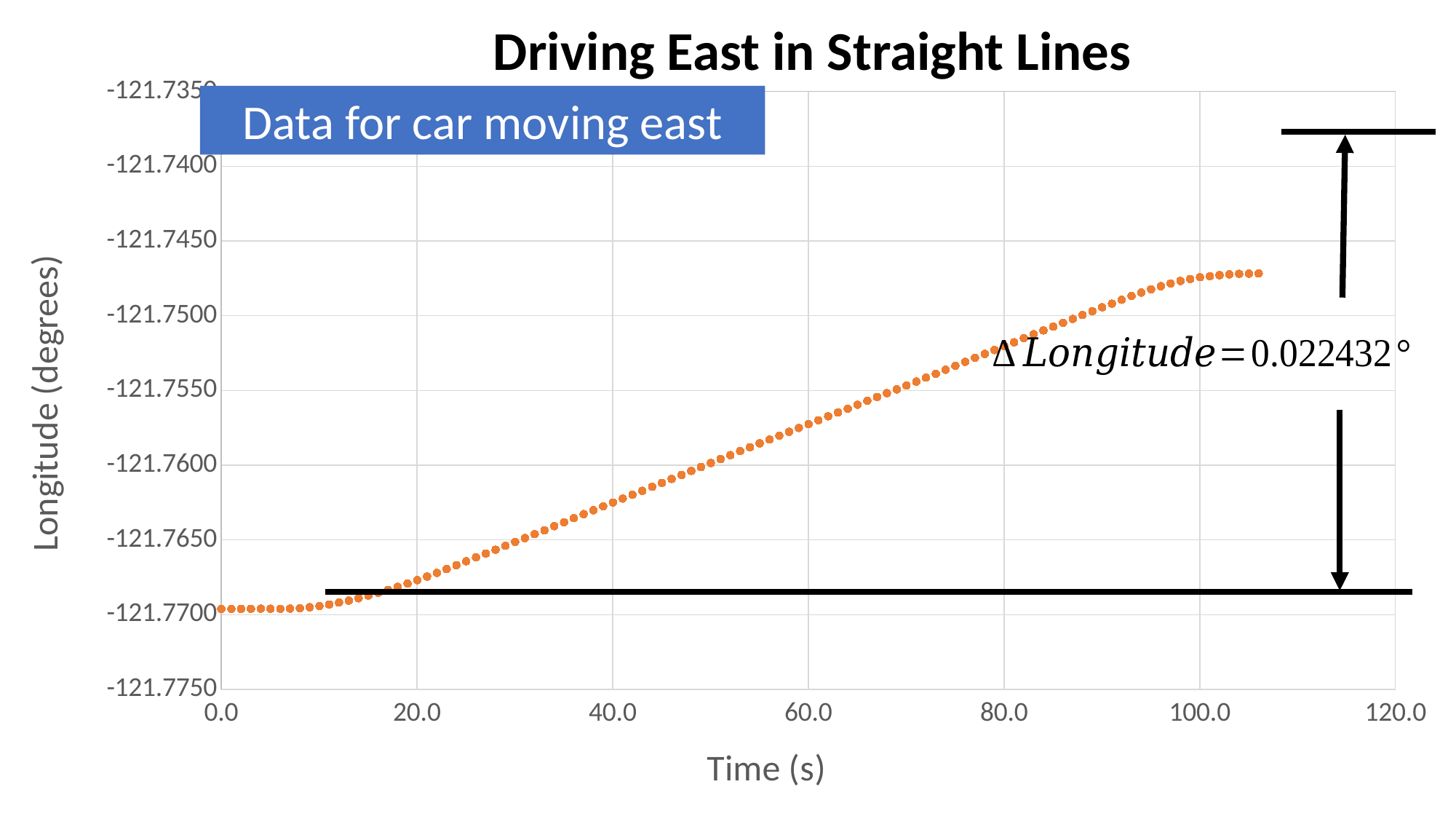
Is the longitude at time 40.0 s greater or less than -121.7650? greater What value of ΔLongitude is annotated on the chart? 0.022432° Is the longitude at time 0.0 s greater or less than -121.7650? less What is the title of the chart? Driving East in Straight Lines Which has the larger longitude value, the point at 20.0 s or the point at 80.0 s? 80.0 s Is the longitude at time 60.0 s greater or less than -121.7600? greater What is the label of the vertical axis? Longitude (degrees) Do the longitude values rise or fall as time increases along the x axis? Rise What kind of chart is shown on the slide? Scatter chart What is the highest tick value shown on the time axis? 120.0